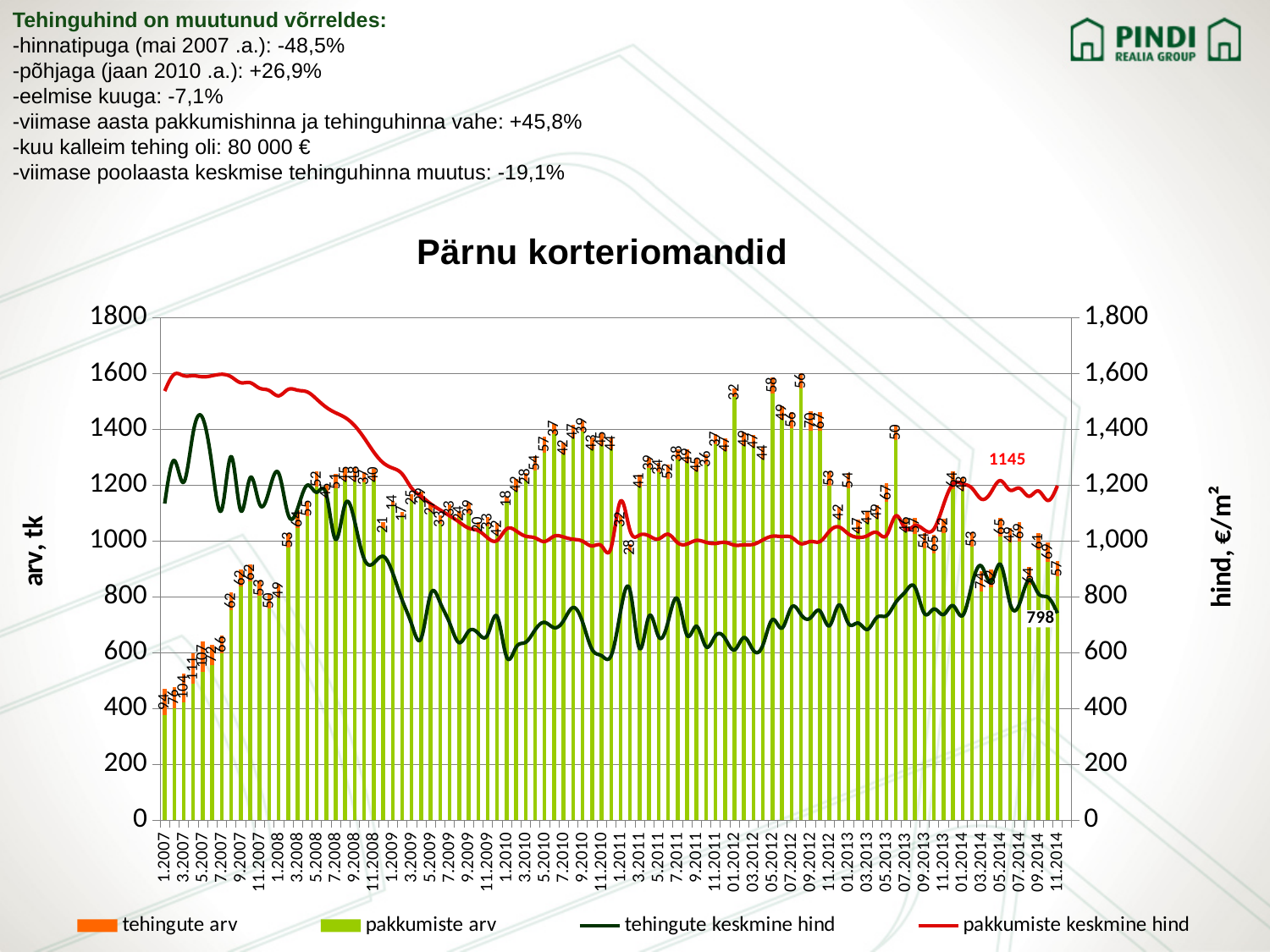
What is the title of the chart? Pärnu korteriomandid What is the difference between pakkumiste keskmine hind (1145) and tehingute keskmine hind (798) at 11.2014? 347 At 11.2014, which is higher: pakkumiste keskmine hind or tehingute keskmine hind? pakkumiste keskmine hind Is the value of pakkumiste keskmine hind at 1.2007 greater or less than 1,400? greater What is the label of the right-hand vertical axis? hind, €/m² Is the value of tehingute keskmine hind at 11.2010 greater or less than 800? less Is the pakkumiste arv bar at 01.2012 greater or less than 1400? greater How many series does the chart legend list? 4 What kind of chart is shown on the slide? Combined bar and line chart Does pakkumiste keskmine hind generally rise or fall from 1.2007 to 11.2014? fall